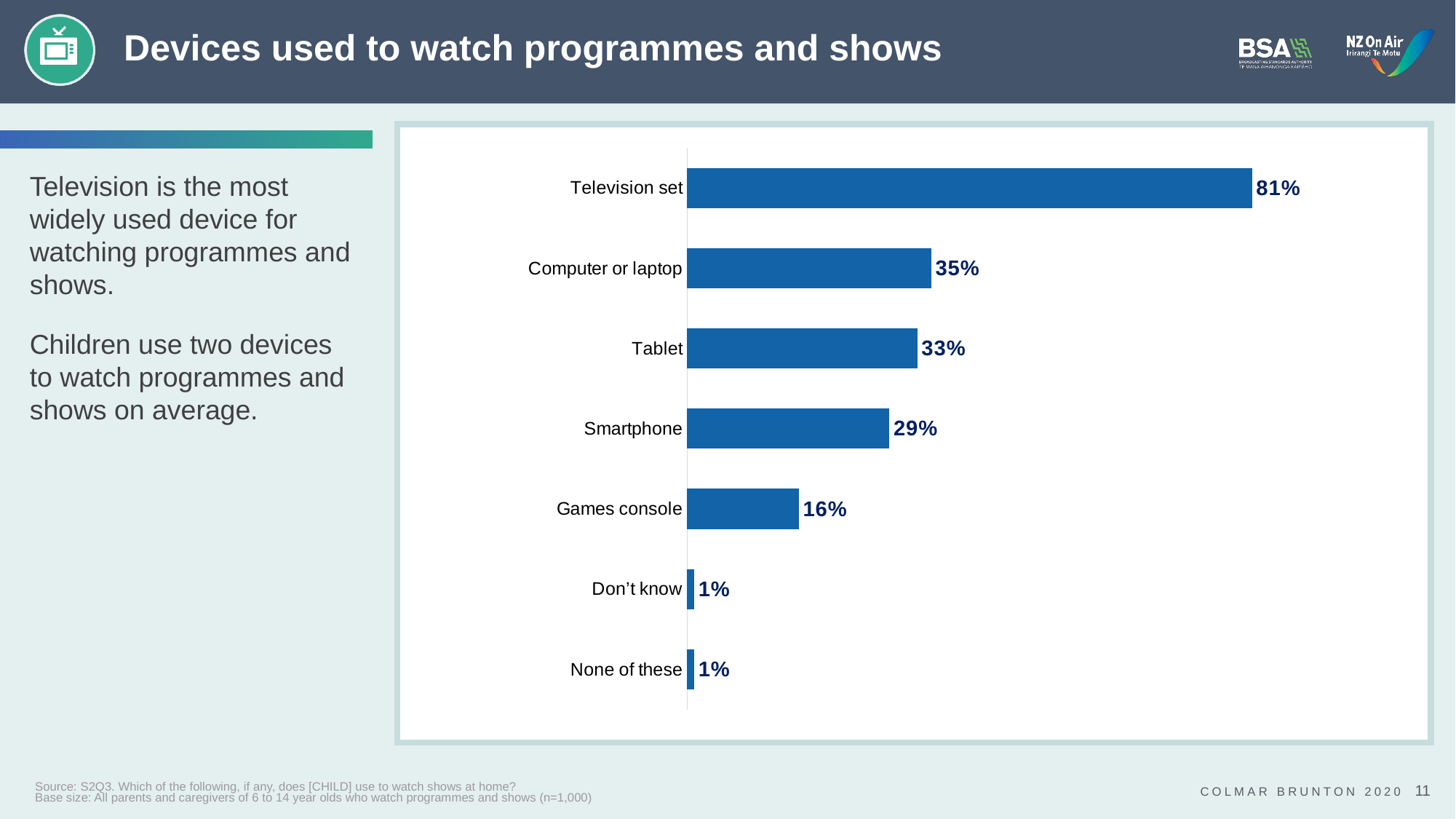
How many categories are shown in the chart? 7 What is the difference between the values for Tablet and Smartphone? 4% What is the value for Smartphone? 29% What percentage of children use a television set to watch programmes and shows? 81% Which is larger, the value for Computer or laptop or the value for Tablet? Computer or laptop What is the value for Games console? 16% Which device has the highest value in the chart? Television set What value is shown for Don't know? 1% What kind of chart is shown on the slide? Bar chart What is the difference between the values for Television set and Computer or laptop? 46% Which is larger, the value for Smartphone or the value for Games console? Smartphone What is the title of the slide containing the chart? Devices used to watch programmes and shows